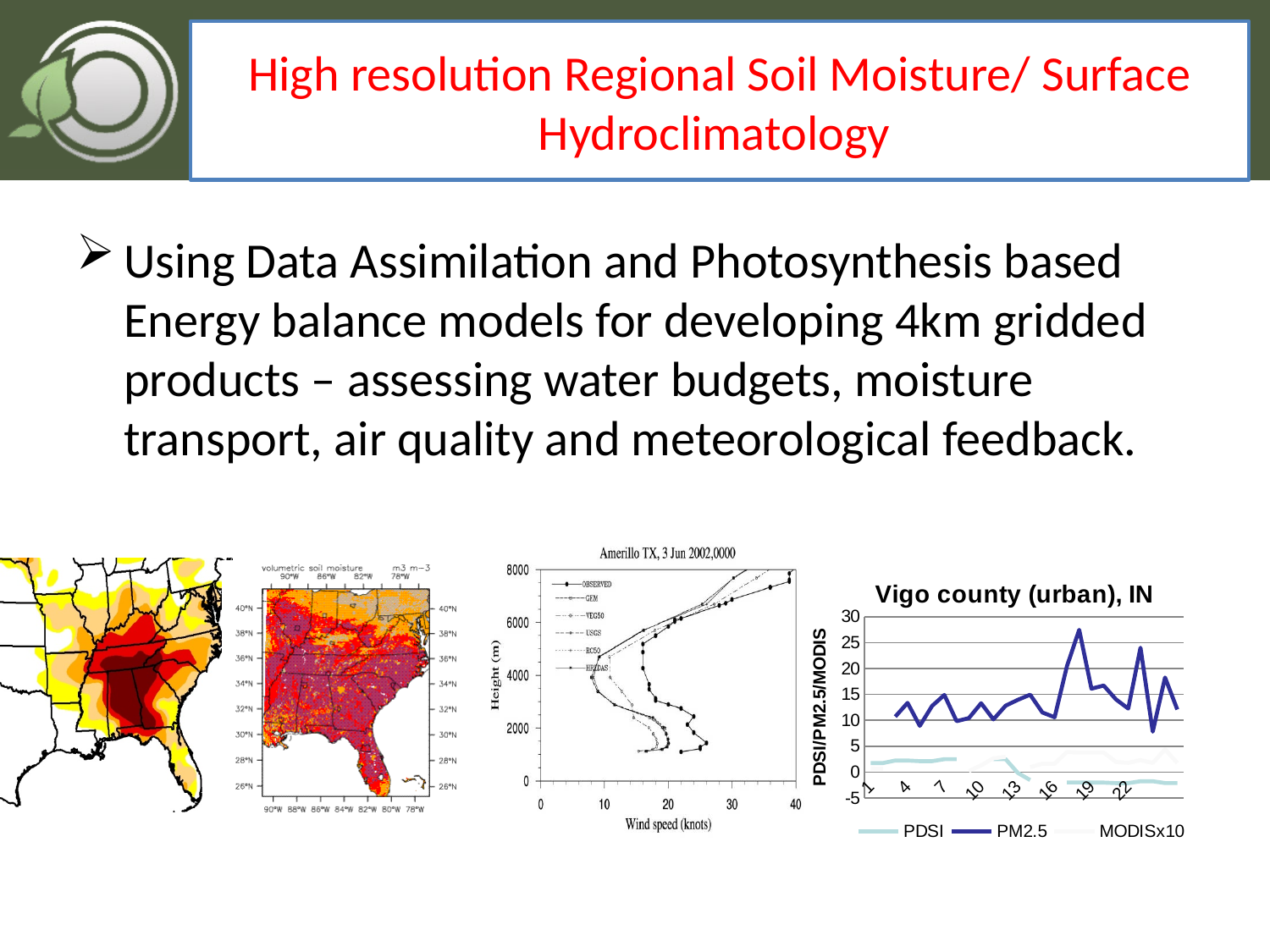
How many series does the legend of the 'Vigo county (urban), IN' chart list? 3 What is the x-axis label of the 'Amerillo TX, 3 Jun 2002,0000' chart? Wind speed (knots) What is the y-axis label of the 'Vigo county (urban), IN' chart? PDSI/PM2.5/MODIS In the 'Vigo county (urban), IN' chart, which series has the lowest values, dropping below zero? PDSI What are the series names in the legend of the 'Vigo county (urban), IN' chart? PDSI, PM2.5, MODISx10 In the 'Vigo county (urban), IN' chart, is the peak value of the PM2.5 series greater or less than 25? greater In the 'Vigo county (urban), IN' chart, which series reaches the highest value? PM2.5 In the 'Vigo county (urban), IN' chart, is the PM2.5 value at point 16 greater or less than 20? less What kind of chart is the 'Vigo county (urban), IN' chart? line chart What kind of chart is the 'Amerillo TX, 3 Jun 2002,0000' chart? line chart In the 'Vigo county (urban), IN' chart, which series is larger at point 19, PM2.5 or PDSI? PM2.5 In the 'Vigo county (urban), IN' chart, is the PDSI value at point 4 greater or less than 5? less